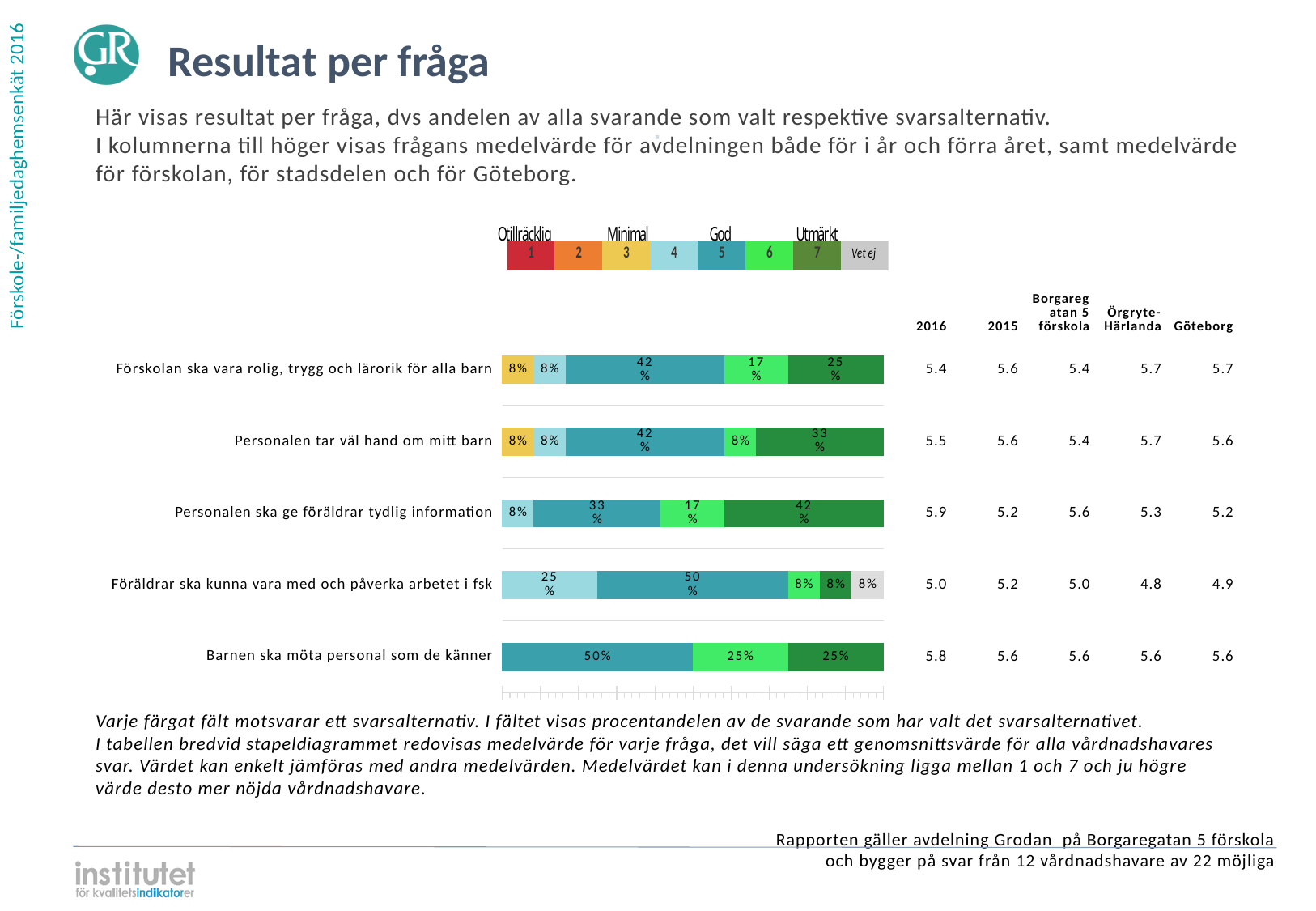
Which question has the largest share of respondents choosing alternative 7 (Utmärkt)? Personalen ska ge föräldrar tydlig information What is the total of the stacked bar for 'Förskolan ska vara rolig, trygg och lärorik för alla barn'? 100% What is the difference in percentage points between the alternative 7 share for 'Personalen tar väl hand om mitt barn' (33%) and for 'Förskolan ska vara rolig, trygg och lärorik för alla barn' (25%)? 8 percentage points Which is larger: the alternative 6 share for 'Barnen ska möta personal som de känner' or for 'Personalen tar väl hand om mitt barn'? Barnen ska möta personal som de känner What is the 2016 mean value shown for 'Personalen ska ge föräldrar tydlig information'? 5.9 How many answer alternatives does the legend above the chart list? 8 How many questions (categories) are plotted in the bar chart? 5 What percentage chose alternative 5 for 'Barnen ska möta personal som de känner'? 50% What percentage chose alternative 7 (Utmärkt) for 'Personalen ska ge föräldrar tydlig information'? 42% What percentage chose 'Vet ej' for 'Föräldrar ska kunna vara med och påverka arbetet i fsk'? 8% Which question has the smallest share of respondents choosing alternative 7 (Utmärkt)? Föräldrar ska kunna vara med och påverka arbetet i fsk What kind of chart is shown on the slide? Stacked bar chart